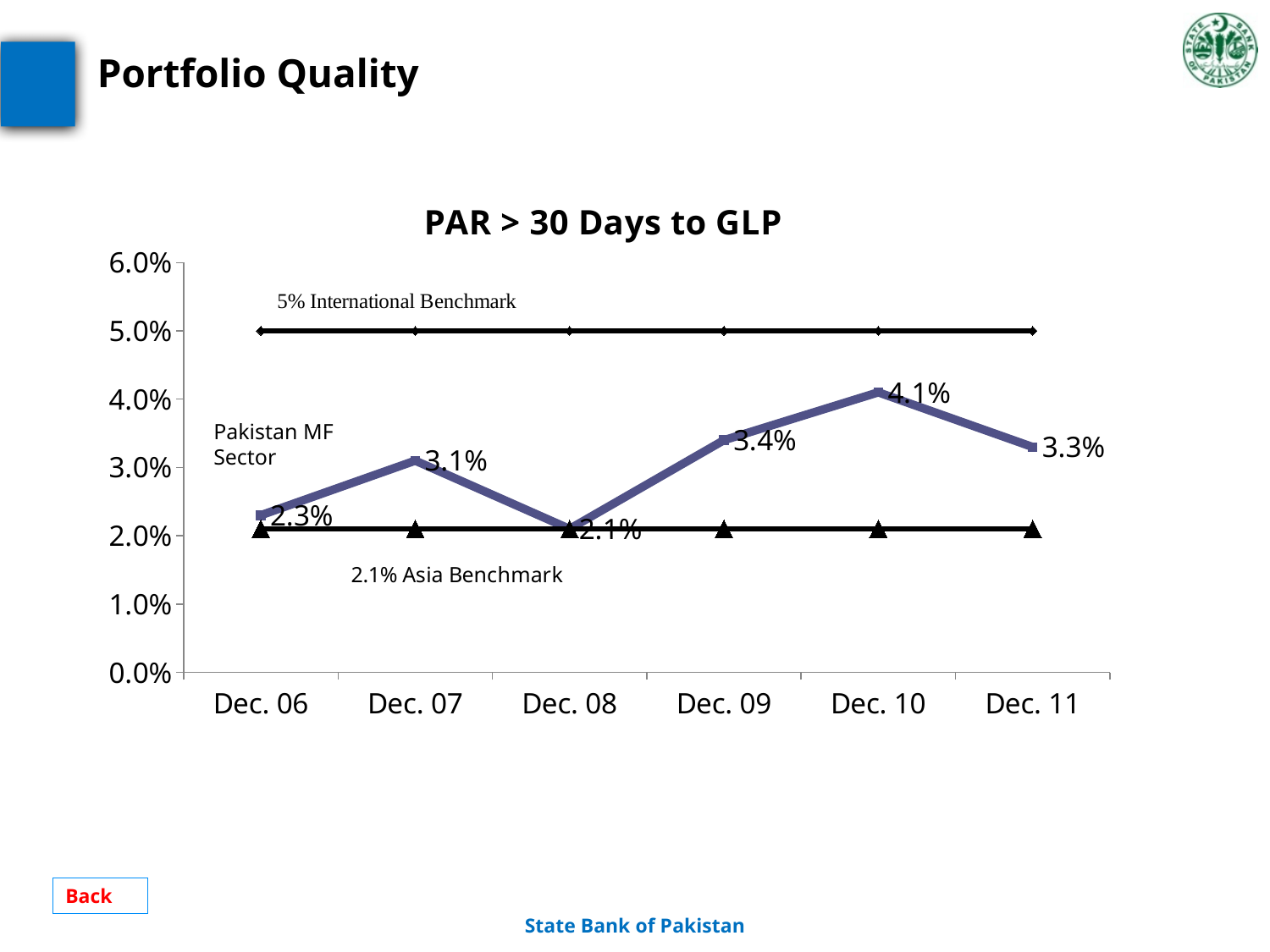
What is the difference between the Pakistan MF Sector values for Dec. 10 and Dec. 08? 2.0% How many time periods are shown on the x axis? 6 What value is the Asia Benchmark line set at? 2.1% In which period is the Pakistan MF Sector value highest? Dec. 10 What kind of chart is shown on the slide? line chart What value is the International Benchmark line set at? 5% What is the title of the chart? PAR > 30 Days to GLP What is the Pakistan MF Sector value for Dec. 11? 3.3% What is the Pakistan MF Sector value for Dec. 10? 4.1% Which is larger, the Pakistan MF Sector value for Dec. 07 or for Dec. 09? Dec. 09 In which period is the Pakistan MF Sector value lowest? Dec. 08 What is the Pakistan MF Sector value for Dec. 06? 2.3%